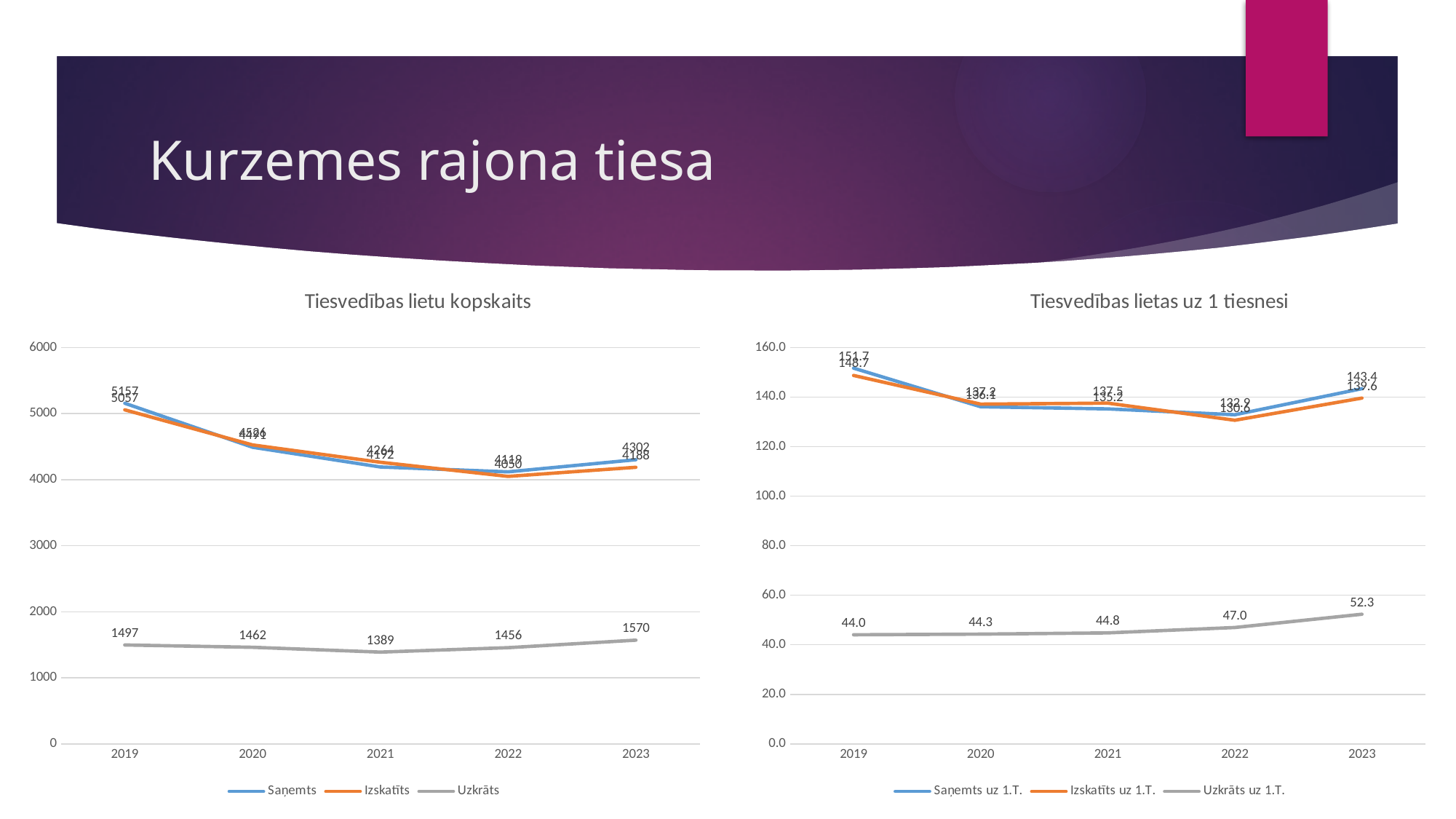
In the chart titled "Tiesvedības lietu kopskaits", in which year is the Uzkrāts series lowest? 2021 In the chart titled "Tiesvedības lietu kopskaits", in which year is the Uzkrāts series highest? 2023 In the chart titled "Tiesvedības lietu kopskaits", what is the value of Saņemts in 2019? 5157 In the chart titled "Tiesvedības lietas uz 1 tiesnesi", what is the difference between Uzkrāts uz 1.T. in 2023 and in 2022? 5.3 In the chart titled "Tiesvedības lietas uz 1 tiesnesi", what is the value of Saņemts uz 1.T. in 2023? 143.4 In the chart titled "Tiesvedības lietu kopskaits", by how much does Uzkrāts in 2023 exceed Uzkrāts in 2019? 73 How many series does the legend of the chart titled "Tiesvedības lietu kopskaits" list? 3 What kind of chart is the chart titled "Tiesvedības lietas uz 1 tiesnesi"? line chart How many years are shown on the x axis of the chart titled "Tiesvedības lietas uz 1 tiesnesi"? 5 In the chart titled "Tiesvedības lietu kopskaits", what is the value of Uzkrāts in 2021? 1389 In the chart titled "Tiesvedības lietas uz 1 tiesnesi", does the Uzkrāts uz 1.T. series rise or fall from 2019 to 2023? rise In the chart titled "Tiesvedības lietas uz 1 tiesnesi", what is the value of Uzkrāts uz 1.T. in 2022? 47.0